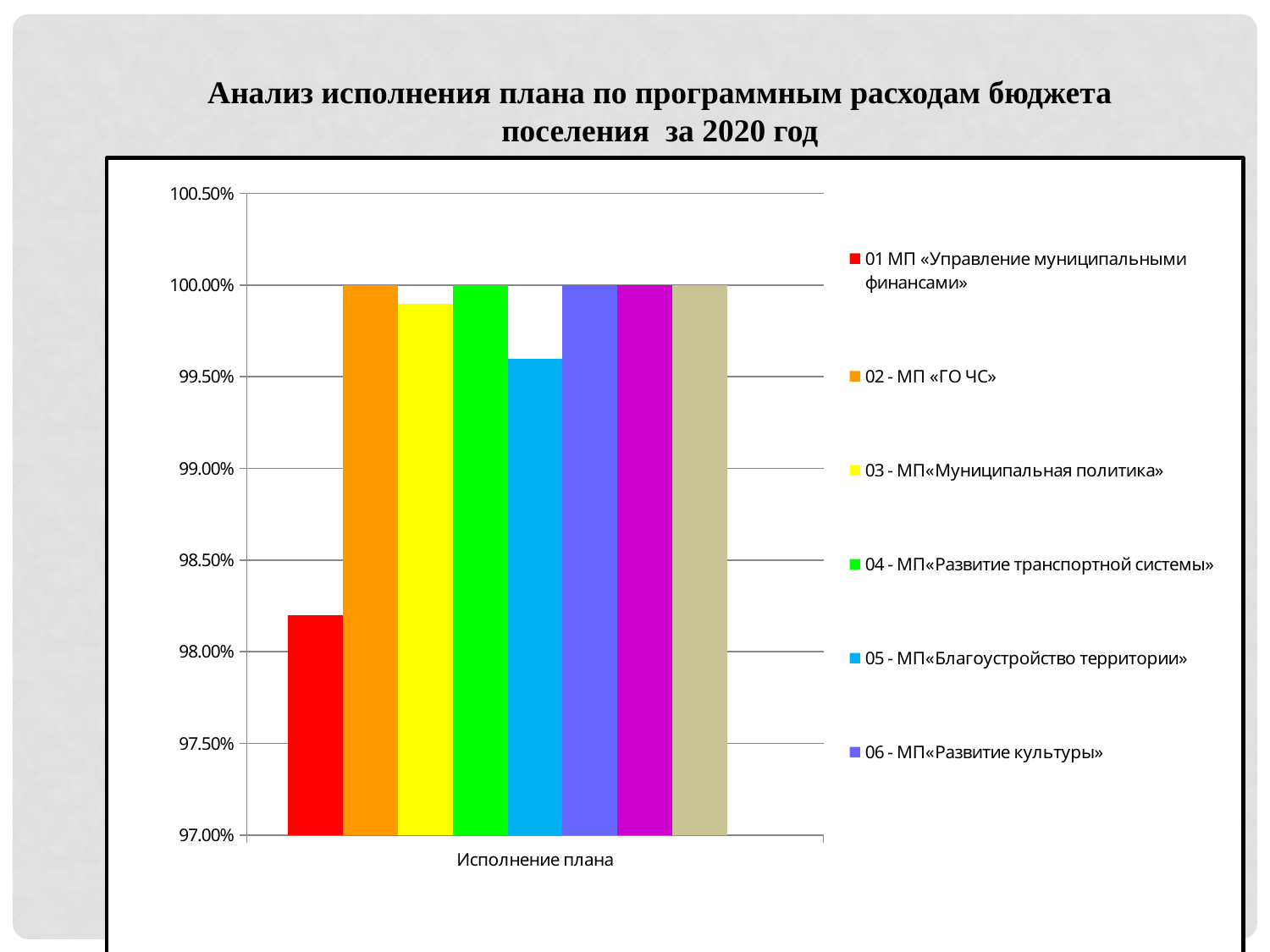
What is the value for 06 - МП«Развитие культуры»? 100.00% Is the value for 01 МП «Управление муниципальными финансами» greater or less than 98.50%? less What is the value for 04 - МП«Развитие транспортной системы»? 100.00% How many bars are plotted in the chart? 8 Which series has the lowest value in the chart? 01 МП «Управление муниципальными финансами» Is the value for 03 - МП«Муниципальная политика» greater or less than 99.50%? greater Is the value for 05 - МП«Благоустройство территории» greater or less than 100.00%? less What kind of chart is shown on the slide? bar chart What is the value for 02 - МП «ГО ЧС»? 100.00% What is the category label shown on the x axis of the chart? Исполнение плана Which is larger: the value for 03 - МП«Муниципальная политика» or the value for 05 - МП«Благоустройство территории»? 03 - МП«Муниципальная политика» How many series does the legend list? 6